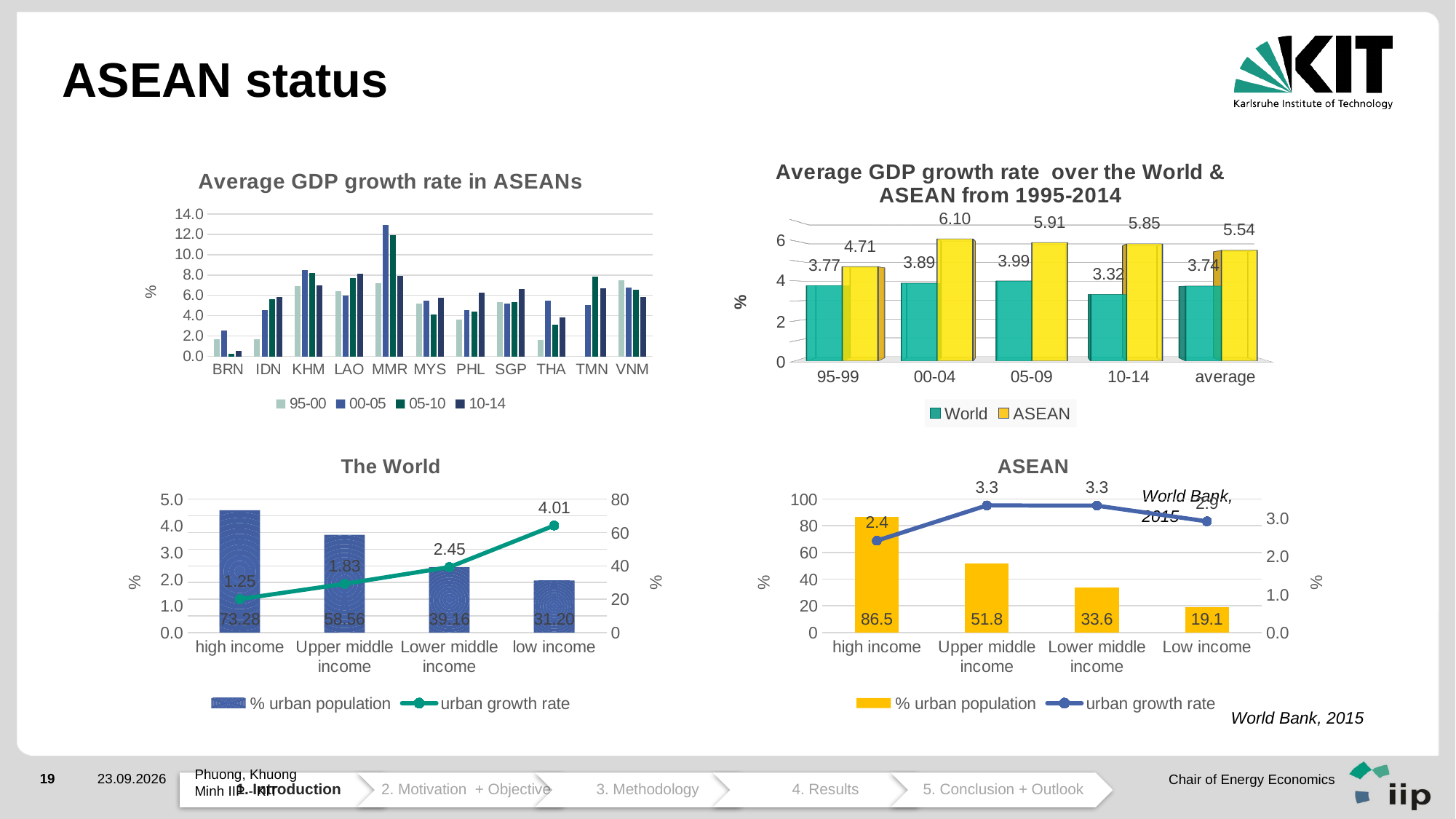
In the chart titled 'The World', what is the urban growth rate for low income? 4.01 In the chart titled 'The World', does the urban growth rate rise or fall from high income to low income? rise In the chart titled 'Average GDP growth rate in ASEANs', is the 00-05 value for MMR greater or less than 12.0? greater In the chart titled 'Average GDP growth rate over the World & ASEAN from 1995-2014', which period has the highest ASEAN value? 00-04 In the chart titled 'Average GDP growth rate in ASEANs', how many countries are shown on the x axis? 11 In the chart titled 'ASEAN', which income group has the lowest urban growth rate? high income In the chart titled 'Average GDP growth rate over the World & ASEAN from 1995-2014', what is the ASEAN value for 00-04? 6.10 In the chart titled 'Average GDP growth rate in ASEANs', how many series does the legend list? 4 In the chart titled 'The World', what is the % urban population for high income? 73.28 In the chart titled 'Average GDP growth rate over the World & ASEAN from 1995-2014', what is the World value for 10-14? 3.32 In the chart titled 'ASEAN', what is the % urban population for Low income? 19.1 In the chart titled 'Average GDP growth rate over the World & ASEAN from 1995-2014', what is the difference between the ASEAN and World values for the 'average' category? 1.80